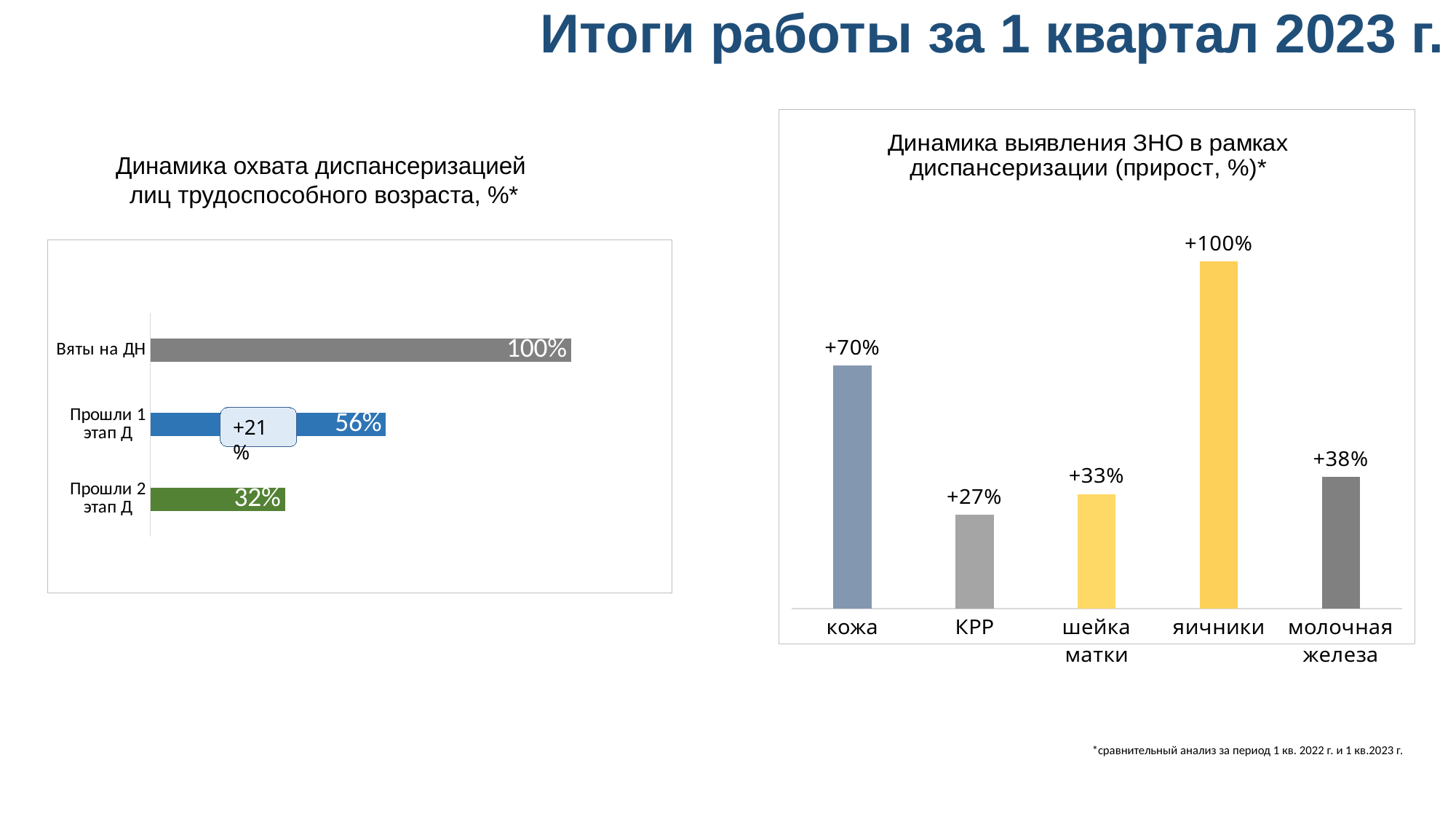
In the right chart (Динамика выявления ЗНО в рамках диспансеризации), which category has the lowest value? КРР In the left chart (Динамика охвата диспансеризацией лиц трудоспособного возраста), how many categories are shown? 3 What type of chart is the left chart (Динамика охвата диспансеризацией лиц трудоспособного возраста)? Bar chart In the right chart (Динамика выявления ЗНО в рамках диспансеризации), what is the value for 'КРР'? +27% In the left chart (Динамика охвата диспансеризацией лиц трудоспособного возраста), what is the difference between 'Прошли 1 этап Д' and 'Прошли 2 этап Д'? 24% In the right chart (Динамика выявления ЗНО в рамках диспансеризации), how many categories are shown? 5 In the right chart (Динамика выявления ЗНО в рамках диспансеризации), which is larger: 'кожа' or 'молочная железа'? кожа In the left chart (Динамика охвата диспансеризацией лиц трудоспособного возраста), what is the value for 'Прошли 1 этап Д'? 56% In the left chart (Динамика охвата диспансеризацией лиц трудоспособного возраста), what is the value for 'Прошли 2 этап Д'? 32% In the left chart (Динамика охвата диспансеризацией лиц трудоспособного возраста), which category has the lowest value? Прошли 2 этап Д In the right chart (Динамика выявления ЗНО в рамках диспансеризации), which category has the highest value? яичники In the right chart (Динамика выявления ЗНО в рамках диспансеризации), what is the value for 'яичники'? +100%